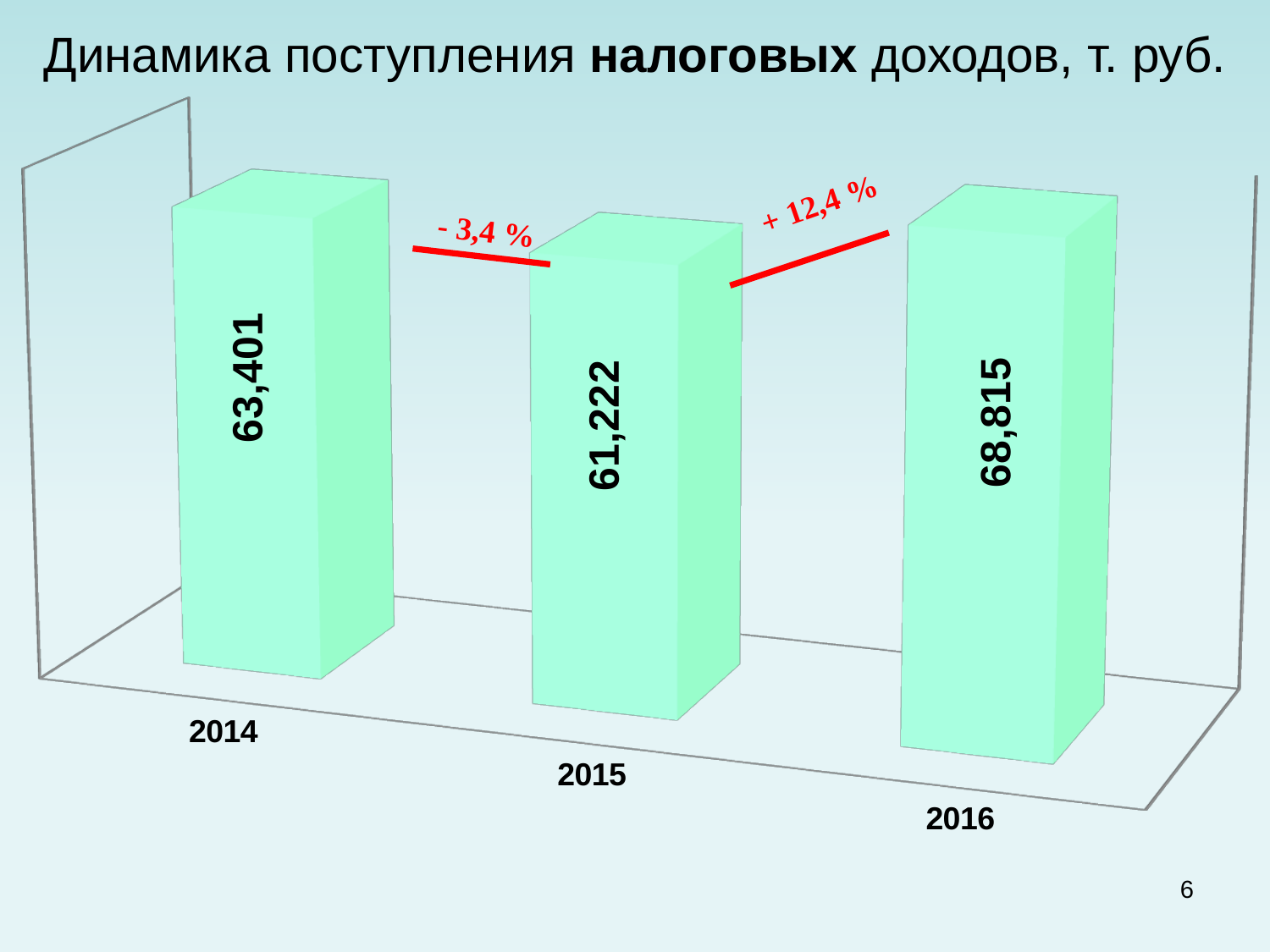
Which year has the lowest value? 2015 What is the value for 2014? 63,401 How many years are shown on the chart? 3 Which is larger, the value for 2014 or the value for 2016? 2016 What is the difference between the values for 2016 and 2015? 7,593 What percentage change is annotated between 2015 and 2016? + 12,4 % What is the difference between the values for 2014 and 2015? 2,179 What kind of chart is shown on the slide? Bar chart What is the value for 2015? 61,222 Which year has the highest value? 2016 What percentage change is annotated between 2014 and 2015? - 3,4 % What is the value for 2016? 68,815